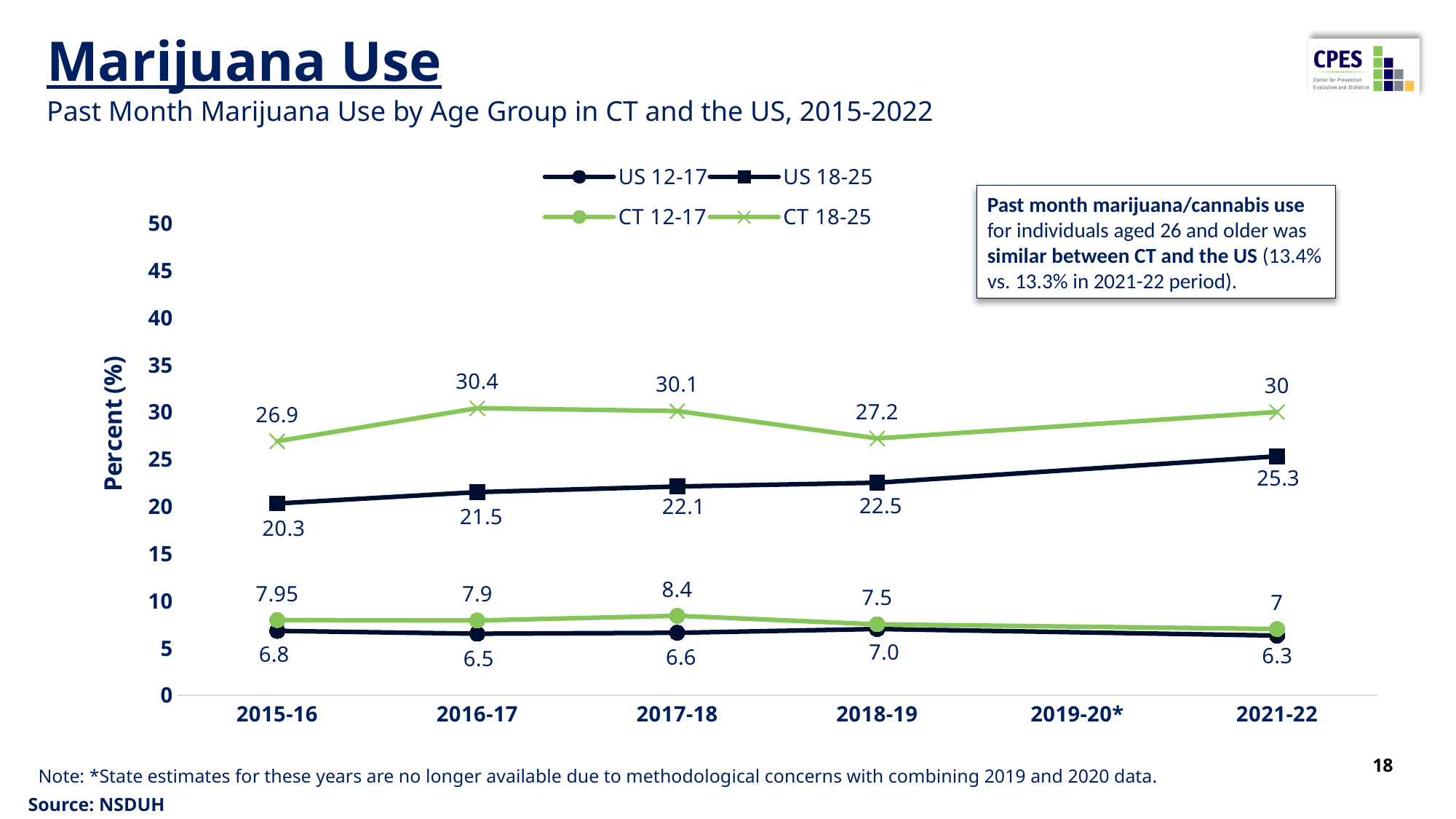
What is the value for US 12-17 in 2018-19? 7.0 Does the US 18-25 series rise or fall from 2015-16 to 2021-22? Rise What is the value for CT 12-17 in 2015-16? 7.95 How many series does the legend list? 4 Is the value for US 18-25 in 2018-19 greater or less than 25? less Which is larger in 2017-18: CT 12-17 or US 12-17? CT 12-17 What is the value for US 18-25 in 2021-22? 25.3 What is the difference between the CT 18-25 and US 18-25 values in 2015-16? 6.6 In which period was the CT 18-25 value lowest? 2015-16 What kind of chart is shown on the slide? Line chart What is the value for CT 18-25 in 2016-17? 30.4 In which period was the US 18-25 value highest? 2021-22